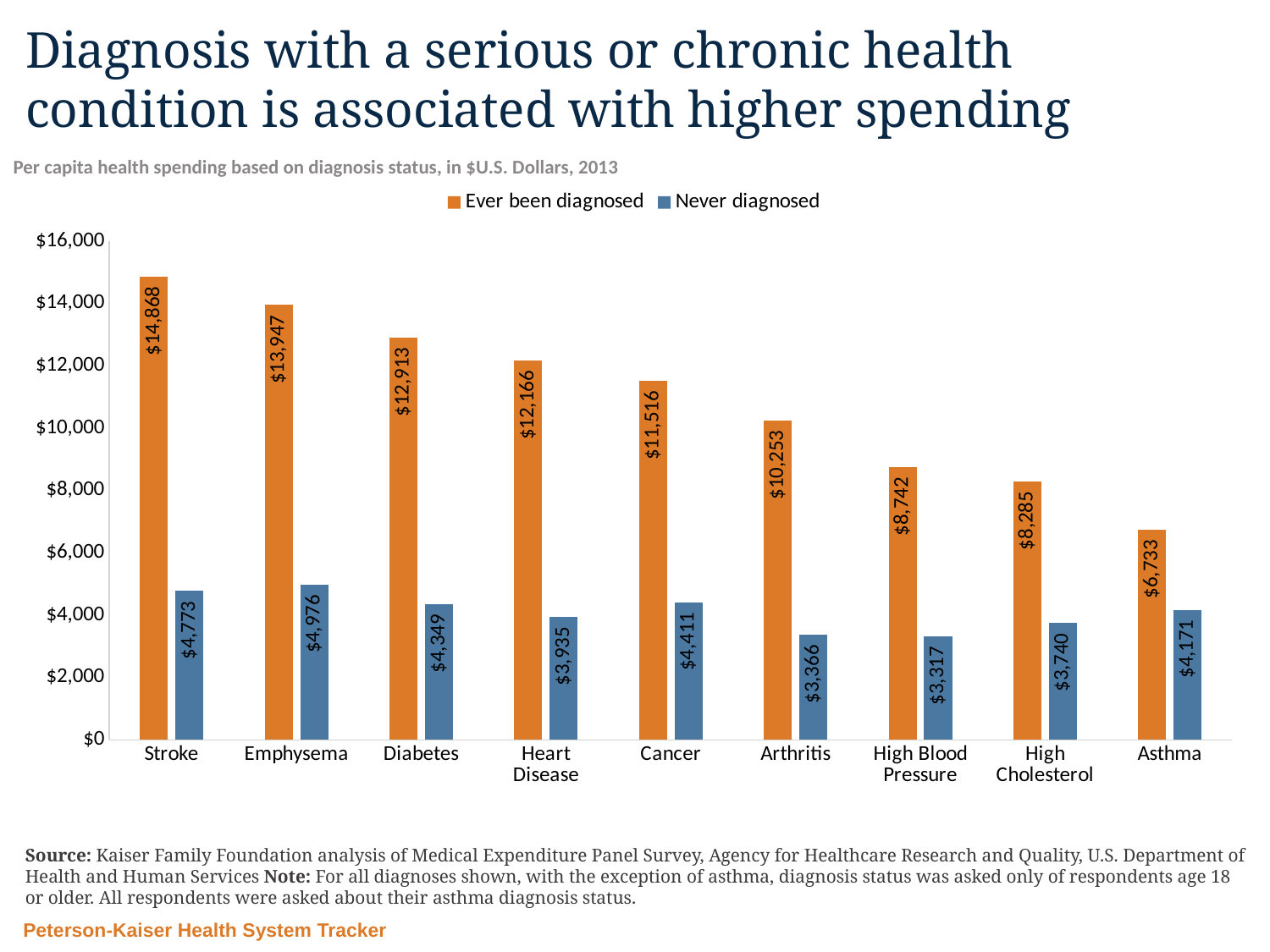
Which is larger: spending for those never diagnosed with emphysema or those never diagnosed with cancer? Never diagnosed with emphysema Which condition has the highest spending among those ever diagnosed? Stroke Which condition has the lowest spending among those ever diagnosed? Asthma What is the difference between spending for those ever diagnosed with diabetes and those never diagnosed with diabetes? $8,564 What is the per capita health spending for people who have ever been diagnosed with stroke? $14,868 What is the per capita health spending for people never diagnosed with arthritis? $3,366 Which colour represents the 'Never diagnosed' series? Blue What kind of chart is shown on the slide? Bar chart How many series does the legend list? 2 Which condition has the lowest spending among those never diagnosed? High Blood Pressure How many health conditions are shown on the x axis? 9 Is the spending for those ever diagnosed with high cholesterol greater or less than $8,000? greater